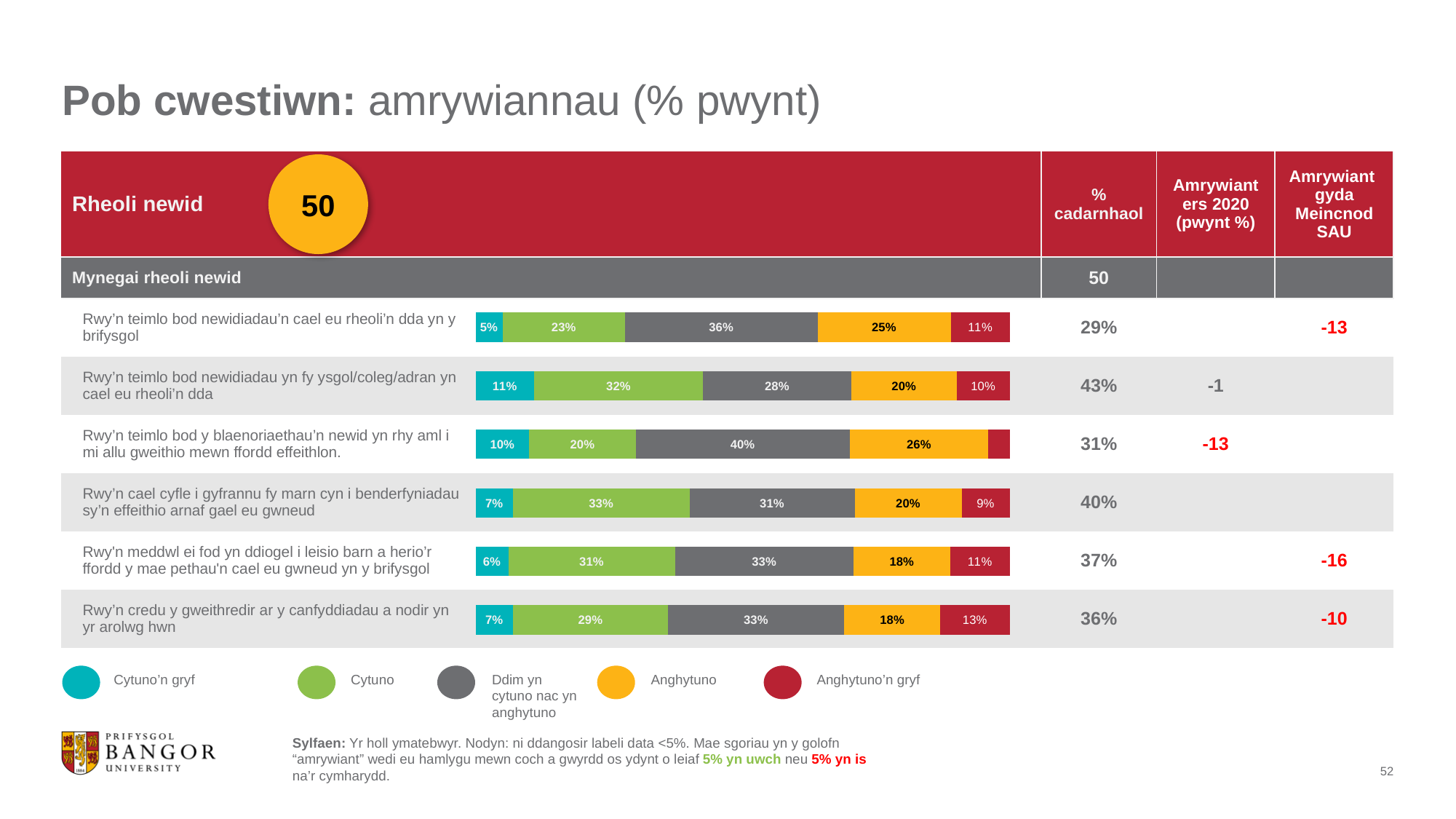
How many response categories does the legend list? 5 What colour represents 'Anghytuno' in the legend? Orange What is the 'Ddim yn cytuno nac yn anghytuno' percentage for the statement 'Rwy'n teimlo bod y blaenoriaethau'n newid yn rhy aml i mi allu gweithio mewn ffordd effeithlon'? 40% Which has the larger 'Ddim yn cytuno nac yn anghytuno' share: 'Rwy'n teimlo bod newidiadau'n cael eu rheoli'n dda yn y brifysgol' or 'Rwy'n teimlo bod newidiadau yn fy ysgol/coleg/adran yn cael eu rheoli'n dda'? Rwy'n teimlo bod newidiadau'n cael eu rheoli'n dda yn y brifysgol (36%) How many statements (bars) are shown in the chart? 6 What is the difference in the 'Cytuno' percentage between 'Rwy'n cael cyfle i gyfrannu fy marn cyn i benderfyniadau sy'n effeithio arnaf gael eu gwneud' and 'Rwy'n credu y gweithredir ar y canfyddiadau a nodir yn yr arolwg hwn'? 4 percentage points What is the 'Amrywiant gyda Meincnod SAU' value for the statement 'Rwy'n meddwl ei fod yn ddiogel i leisio barn a herio'r ffordd y mae pethau'n cael eu gwneud yn y brifysgol'? -16 What is the 'Cytuno' percentage for the statement 'Rwy'n teimlo bod newidiadau yn fy ysgol/coleg/adran yn cael eu rheoli'n dda'? 32% Which statement has the lowest '% cadarnhaol' value? Rwy'n teimlo bod newidiadau'n cael eu rheoli'n dda yn y brifysgol (29%) What is the 'Anghytuno'n gryf' percentage for the statement 'Rwy'n credu y gweithredir ar y canfyddiadau a nodir yn yr arolwg hwn'? 13% What kind of chart is used to show the responses to each statement on this slide? Stacked bar chart Which statement has the highest 'Cytuno'n gryf' percentage? Rwy'n teimlo bod newidiadau yn fy ysgol/coleg/adran yn cael eu rheoli'n dda (11%)